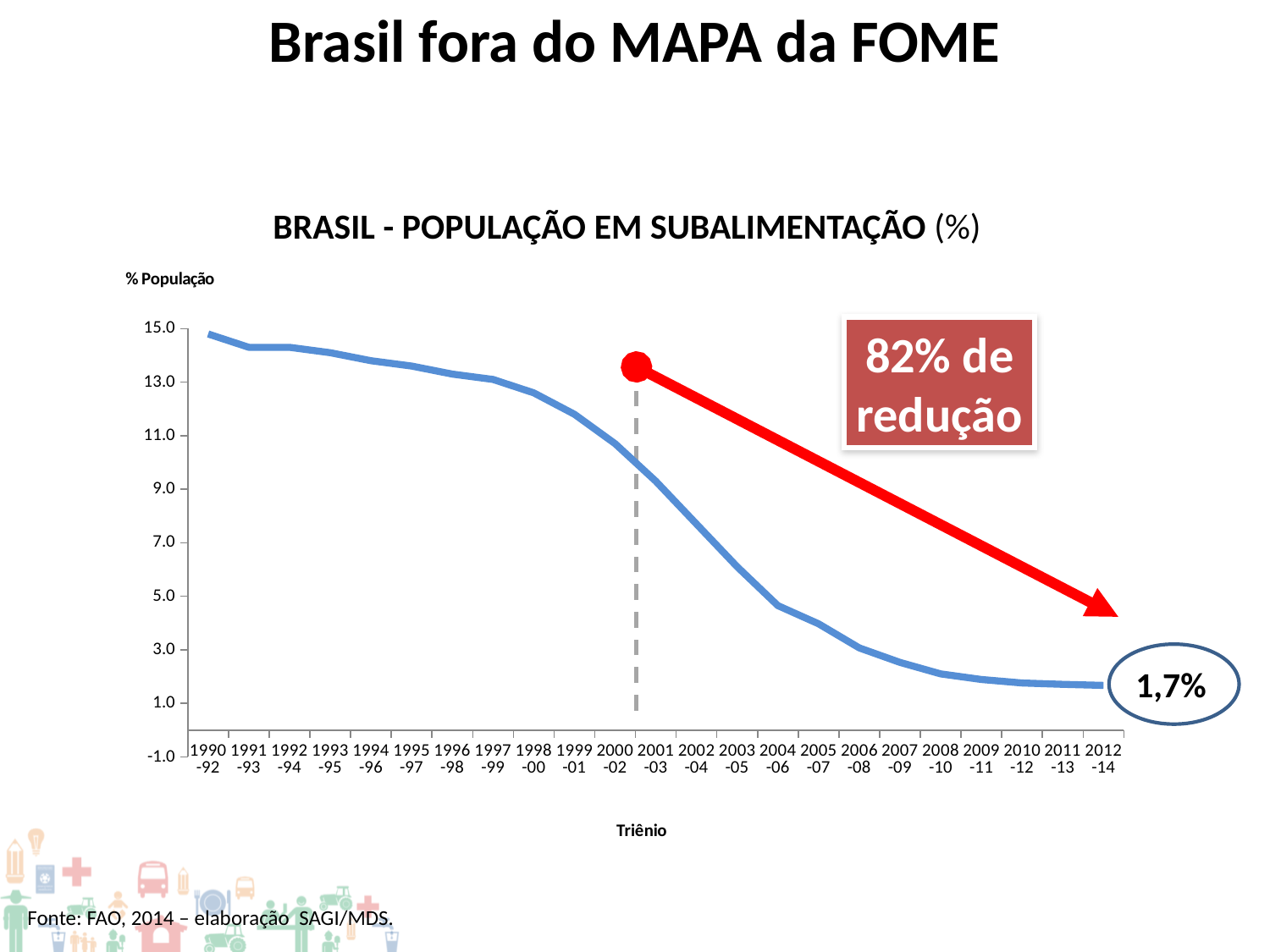
Which triennium has the highest value on the chart? 1990-92 Is the value for 2008-10 greater or less than 3.0? less Which is larger, the value for 1995-97 or the value for 2006-08? 1995-97 What kind of chart is shown on the slide? line chart Do the values rise or fall from 1990-92 to 2012-14? fall What is the title of the chart? BRASIL - POPULAÇÃO EM SUBALIMENTAÇÃO (%) Is the value for 1990-92 greater or less than 13.0? greater How many trienniums are plotted on the x axis? 23 What value is labelled for the 2012-14 triennium? 1,7% Which triennium has the lowest value on the chart? 2012-14 Is the value for 2000-02 greater or less than 9.0? greater